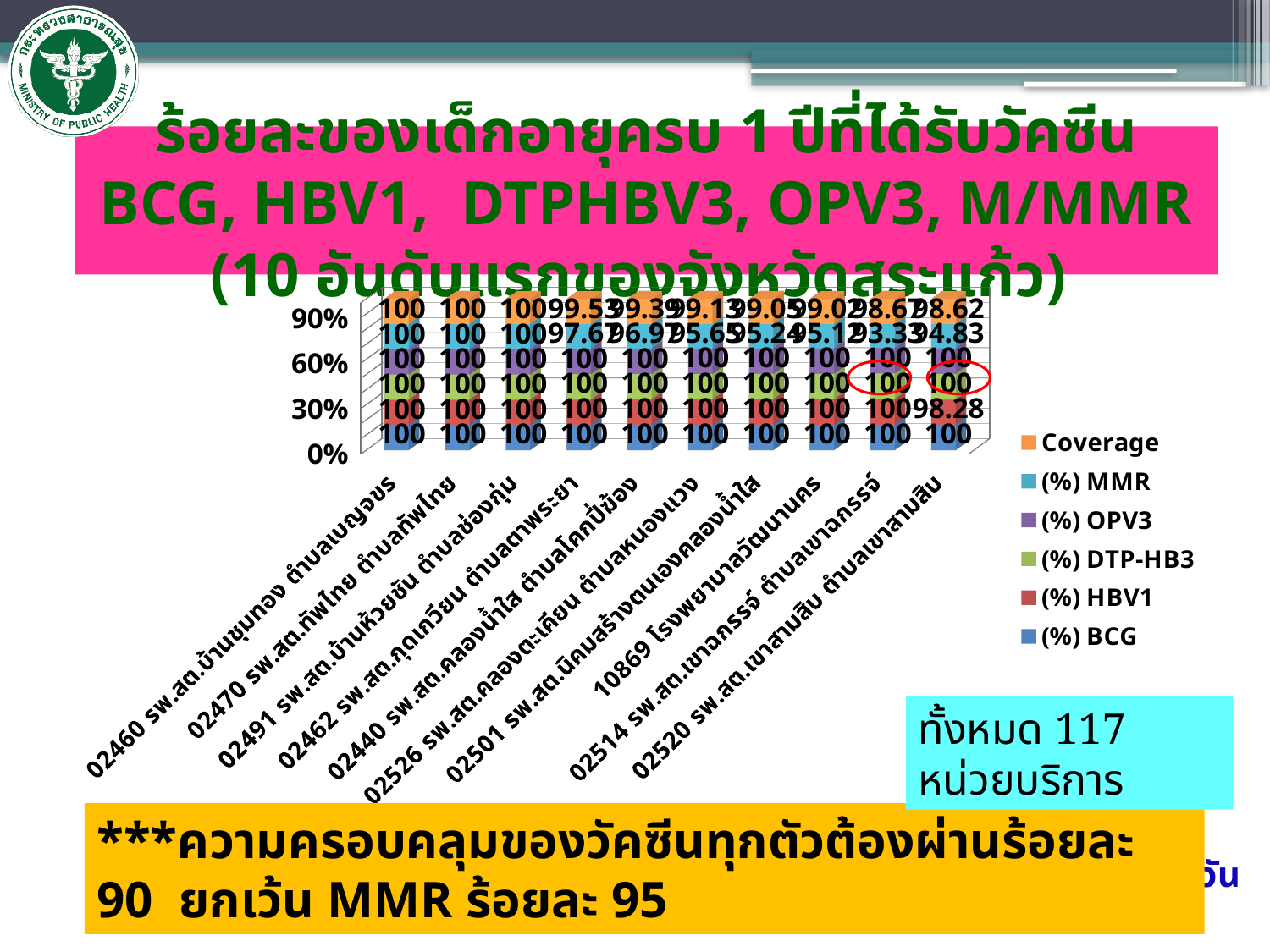
How many health service units (categories) are shown on the x axis of the chart? 10 What is the (%) OPV3 value for 10869 โรงพยาบาลวัฒนานคร? 100 Which legend entry is listed last (at the bottom) in the chart legend? (%) BCG What kind of chart is shown on the slide? Stacked bar chart What is the (%) HBV1 value for 02520 รพ.สต.เขาสามสิบ ตำบลเขาสามสิบ? 98.28 What is the difference between the (%) HBV1 value for 02460 รพ.สต.บ้านชุมทอง (100) and for 02520 รพ.สต.เขาสามสิบ (98.28)? 1.72 How many series does the chart legend list? 6 What is the (%) MMR value for 02491 รพ.สต.บ้านห้วยชัน ตำบลช่องกุ่ม? 100 What is the Coverage value for 02470 รพ.สต.ทัพไทย ตำบลทัพไทย? 100 Which is larger, the (%) HBV1 value for 02460 รพ.สต.บ้านชุมทอง or for 02520 รพ.สต.เขาสามสิบ? 02460 รพ.สต.บ้านชุมทอง Which series is shown in orange in the chart legend? Coverage What is the (%) BCG value for 02460 รพ.สต.บ้านชุมทอง ตำบลเบญจขร? 100